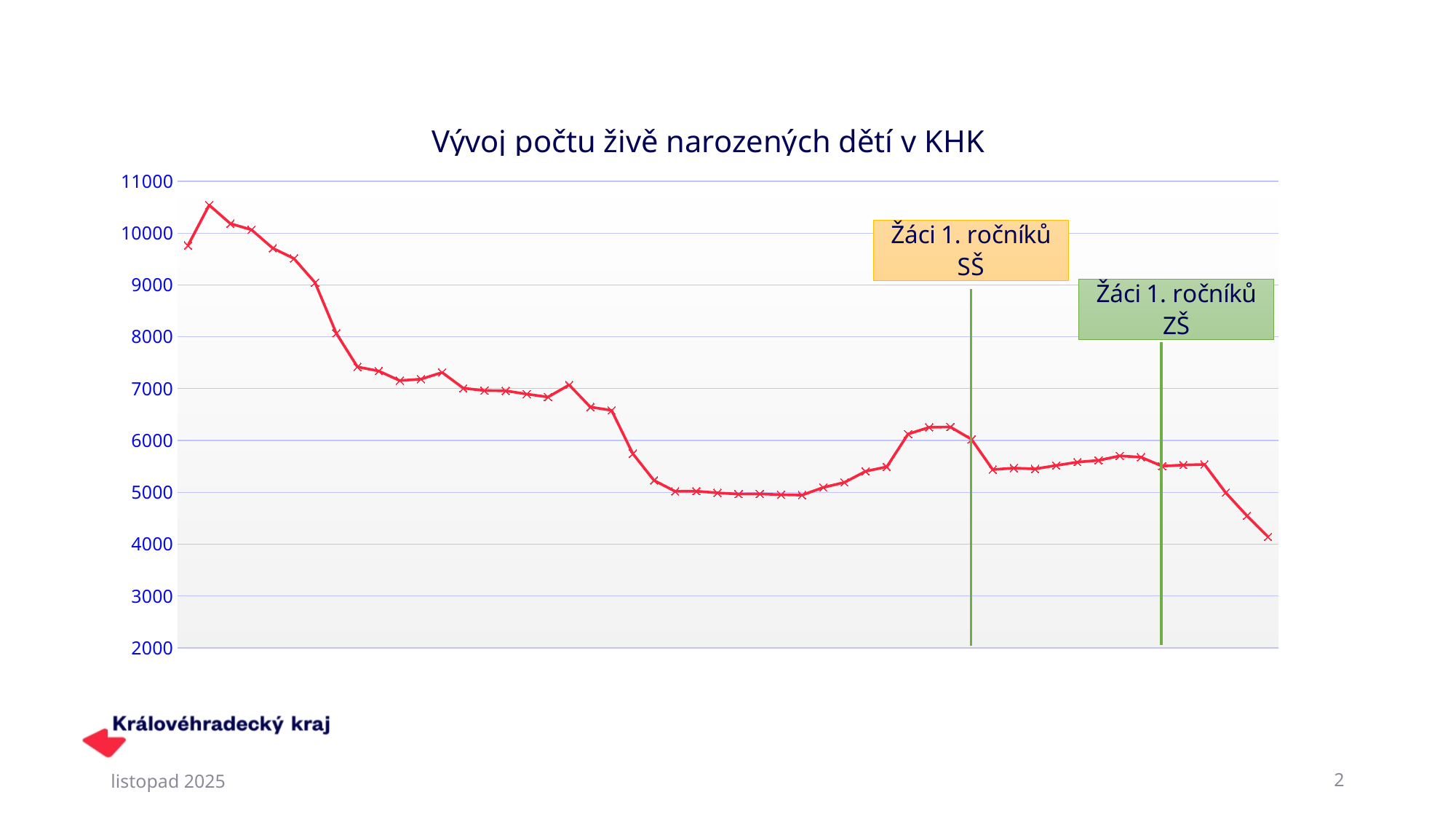
What are the two annotation labels placed above the vertical green lines on the chart? Žáci 1. ročníků SŠ and Žáci 1. ročníků ZŠ Overall, do the values rise or fall from left to right along the x axis? fall Is the lowest point of the line greater or less than 4000? greater Is the last point of the line greater or less than 5000? less Is the highest point of the line near the start or near the end of the series? near the start Is the lowest point of the line near the start or near the end of the series? near the end Is the first point of the line greater or less than 9000? greater What kind of chart is shown on the slide? line chart What is the highest value shown on the y axis? 11000 What is the title of the chart? Vývoj počtu živě narozených dětí v KHK Which is larger, the first point of the line or the last point of the line? the first point